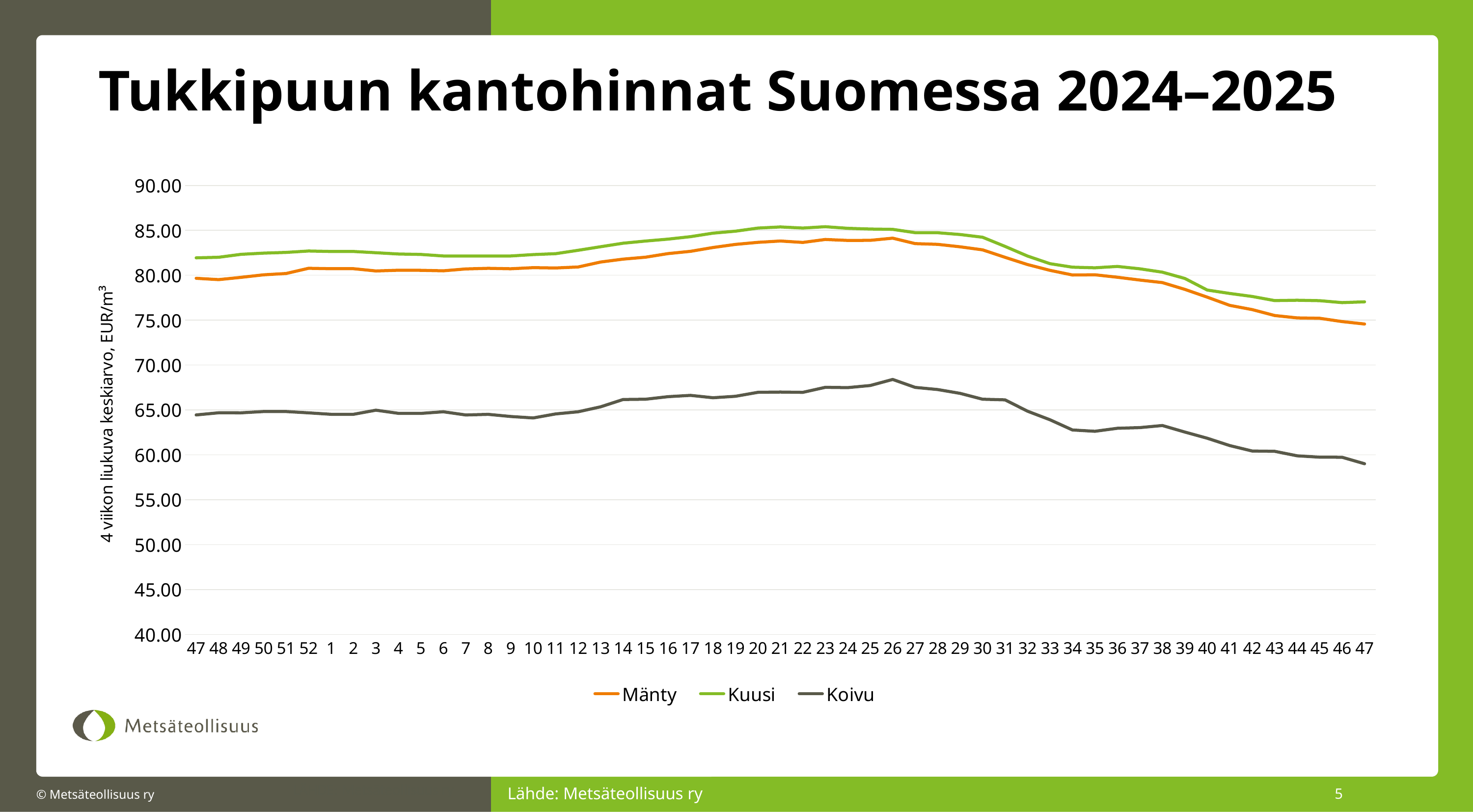
What is the title of the chart? Tukkipuun kantohinnat Suomessa 2024–2025 Does the Koivu line rise or fall from week 26 to the final week 47? fall Is the value for Mänty at the final week 47 greater or less than 75? less What is the label of the vertical axis? 4 viikon liukuva keskiarvo, EUR/m³ Which series is plotted with the highest values throughout the chart? Kuusi How many series does the legend list? 3 Is the value for Koivu at the final week 47 greater or less than 60? less At week 20, which series has the larger value, Kuusi or Mänty? Kuusi What kind of chart is shown on the slide? line chart Is the value for Kuusi at the first week 47 greater or less than 80? greater Which series is plotted with the lowest values throughout the chart? Koivu